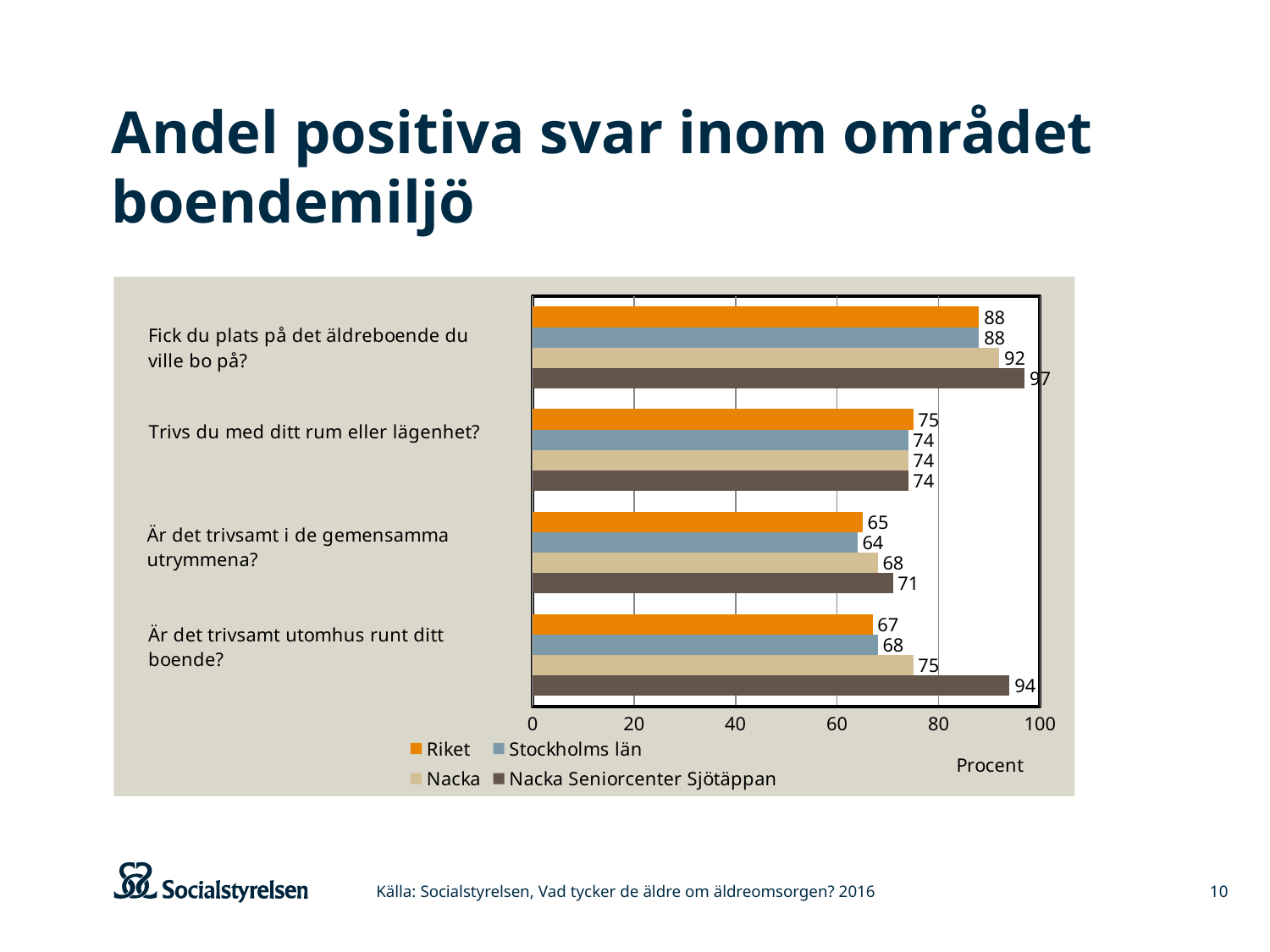
What value is shown for Nacka on "Fick du plats på det äldreboende du ville bo på?"? 92 Which series has the lowest value on "Är det trivsamt i de gemensamma utrymmena?"? Stockholms län How many questions (categories) are shown on the chart? 4 What is the difference between Nacka Seniorcenter Sjötäppan and Riket on "Är det trivsamt utomhus runt ditt boende?"? 27 Which is larger on "Är det trivsamt i de gemensamma utrymmena?": Nacka or Nacka Seniorcenter Sjötäppan? Nacka Seniorcenter Sjötäppan What kind of chart is shown on the slide? Bar chart What value is shown for Riket on "Trivs du med ditt rum eller lägenhet?"? 75 What value is shown for Stockholms län on "Är det trivsamt i de gemensamma utrymmena?"? 64 Which series has the highest value on "Fick du plats på det äldreboende du ville bo på?"? Nacka Seniorcenter Sjötäppan What value is shown for Nacka Seniorcenter Sjötäppan on "Är det trivsamt utomhus runt ditt boende?"? 94 How many series does the legend list? 4 What unit is labelled on the horizontal axis? Procent